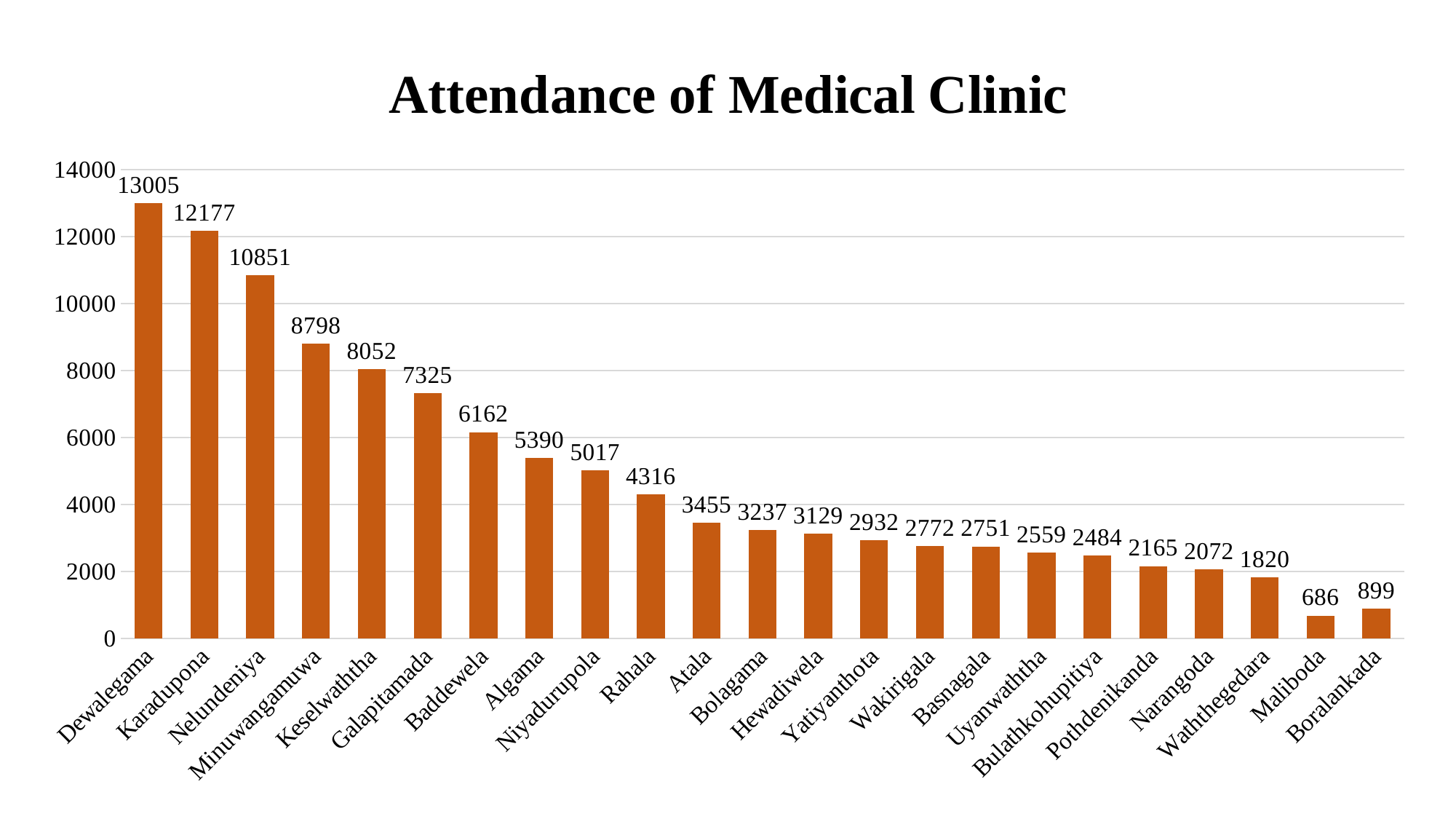
What is the attendance value for Waththegedara? 1820 What is the difference in attendance between Boralankada and Maliboda? 213 Which has higher attendance, Rahala or Atala? Rahala What is the title of the chart? Attendance of Medical Clinic What type of chart is shown on the slide? Bar chart What is the difference in attendance between Dewalegama and Karadupona? 828 Which clinic has the lowest attendance? Maliboda Is the value for Galapitamada greater or less than 8000? less How many clinics are shown on the chart? 23 What is the attendance value for Yatiyanthota? 2932 Which clinic has the highest attendance? Dewalegama What is the attendance value for Keselwaththa? 8052